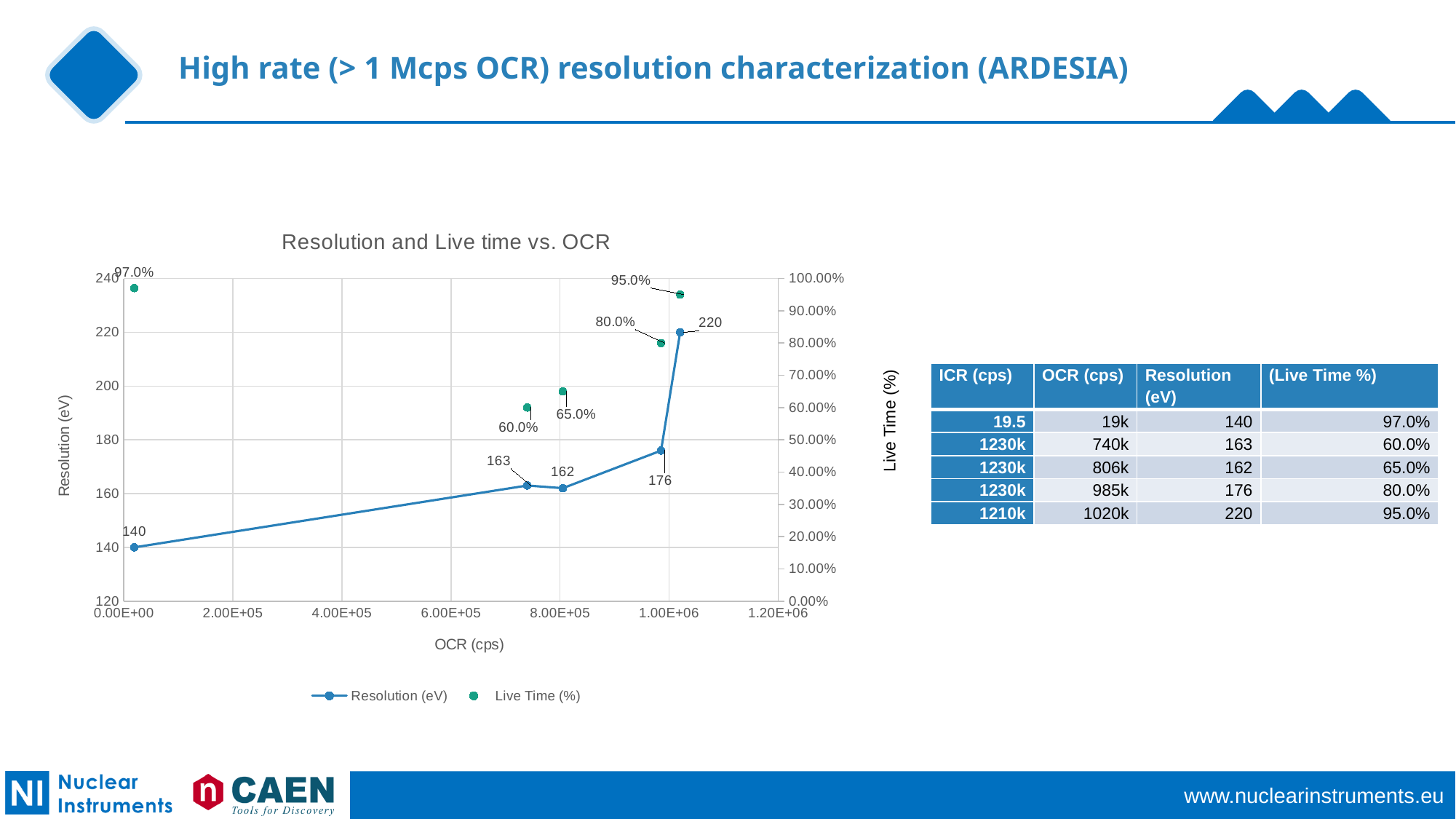
How many series does the chart legend list? 2 Which is larger: the Resolution (eV) value labelled at about 8.00E+05 OCR (162) or the one labelled at about 1.00E+06 OCR (176)? 176 How many data points are plotted for the Resolution (eV) series? 5 What kind of chart is shown on the slide? line chart What is the highest labelled Live Time (%) value on the chart? 97.0% What is the title of the chart? Resolution and Live time vs. OCR What is the lowest labelled Resolution (eV) value on the chart? 140 What is the lowest labelled Live Time (%) value on the chart? 60.0% What is the difference between the highest and lowest labelled Resolution (eV) values? 80 Does the Resolution (eV) line generally rise or fall as OCR increases along the x axis? rise What is the highest labelled Resolution (eV) value on the chart? 220 What is the label of the x axis of the chart? OCR (cps)